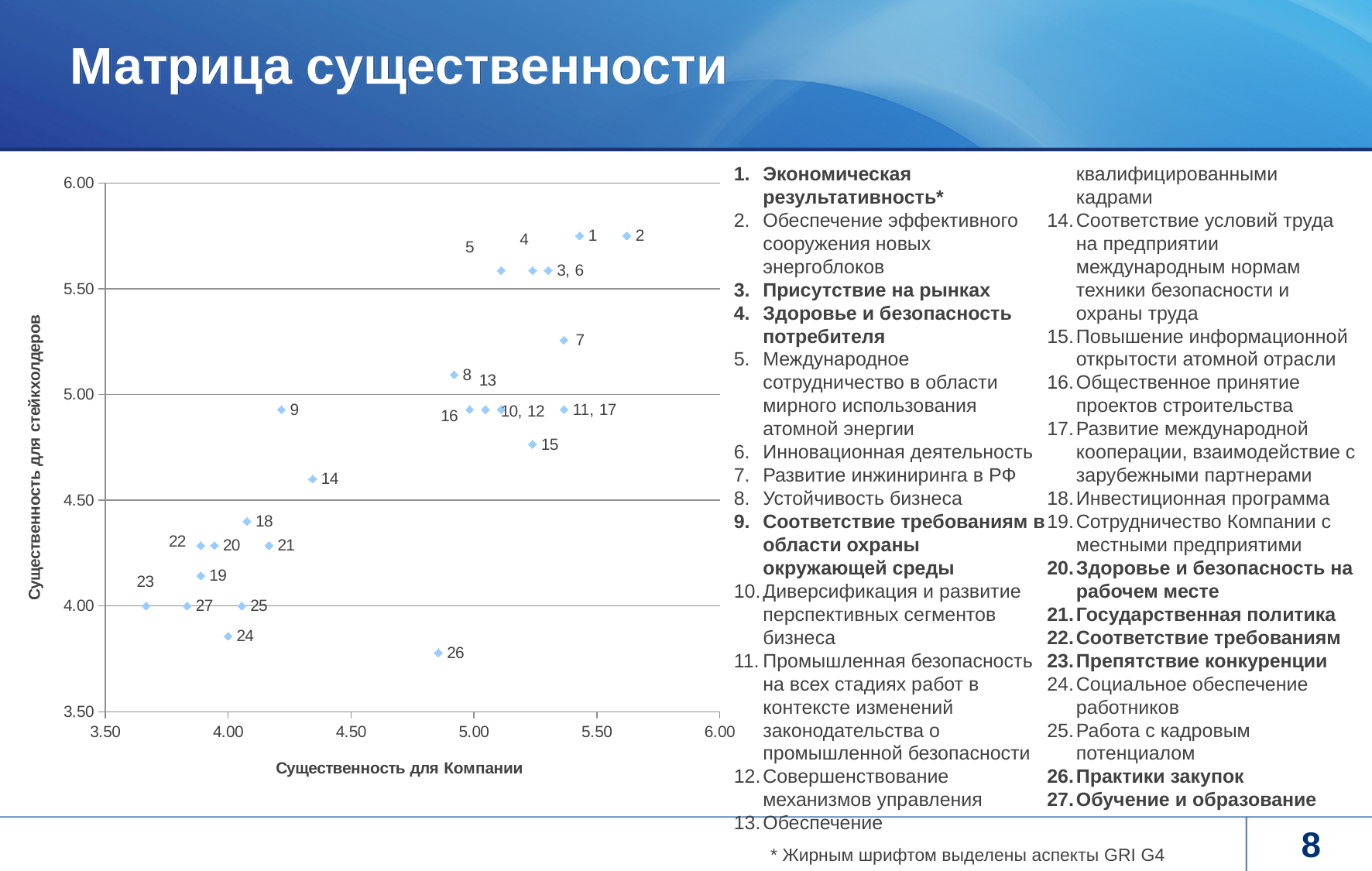
Is the horizontal-axis value for point 9 greater or less than 4.50? less Which point has the lowest value on the horizontal axis (Существенность для Компании)? 23 Which point has the highest value on the horizontal axis (Существенность для Компании)? 2 Which point is higher on the vertical axis, point 7 or point 15? 7 Which point is further right on the horizontal axis, point 26 or point 24? 26 What is the title of the horizontal axis of the chart? Существенность для Компании Is the vertical-axis value for point 26 greater or less than 4.00? less Is the vertical-axis value for point 7 greater or less than 5.00? greater How many numbered aspects are listed in the legend next to the chart? 27 What kind of chart is shown on the slide? scatter chart What is the title of the vertical axis of the chart? Существенность для стейкхолдеров